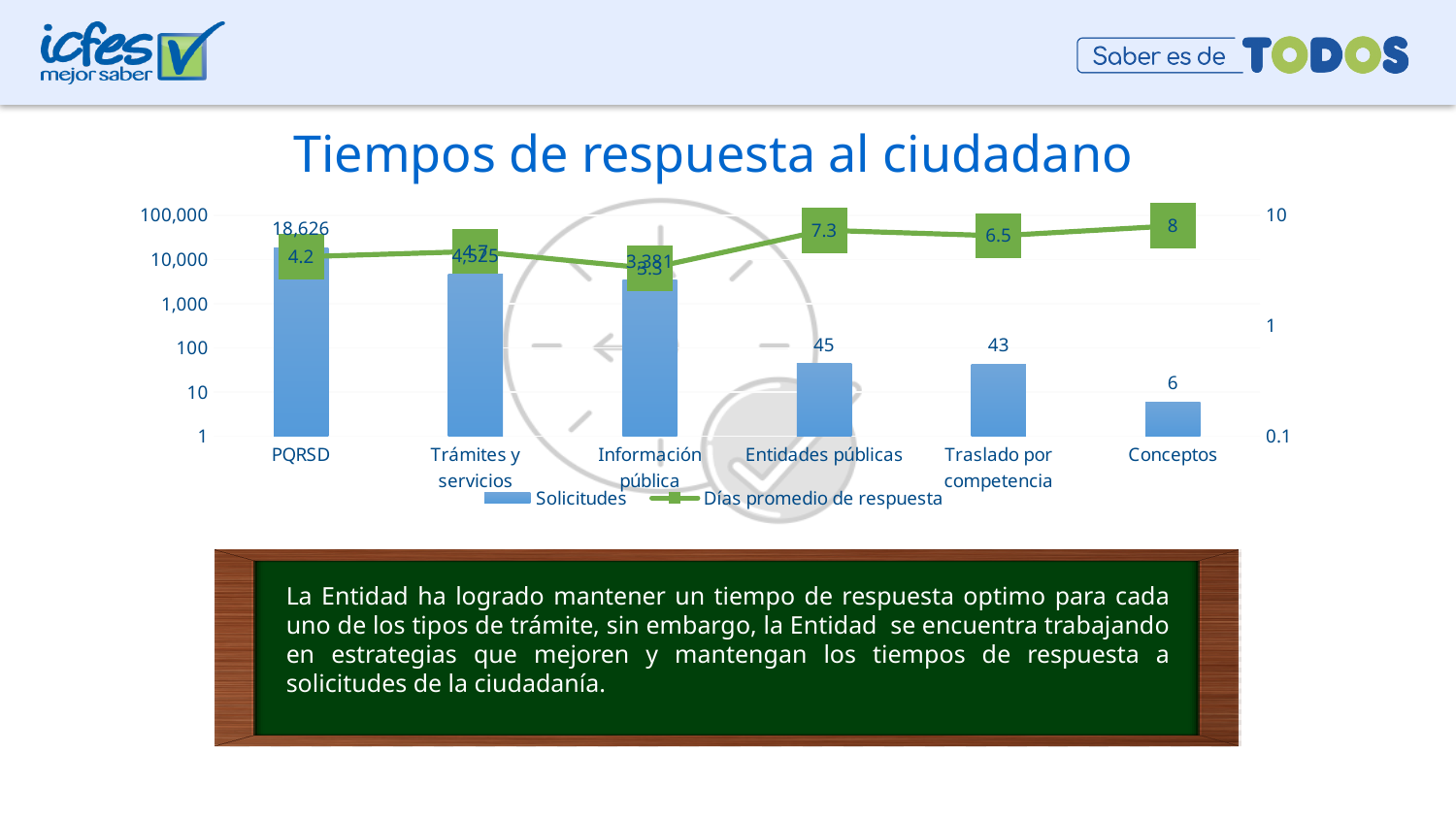
What is the Solicitudes value for PQRSD? 18,626 What is the Días promedio de respuesta value for Entidades públicas? 7.3 How many categories are shown on the x axis? 6 What is the difference in Solicitudes between Entidades públicas and Traslado por competencia? 2 Which category has the highest Solicitudes value? PQRSD What is the Días promedio de respuesta value for Traslado por competencia? 6.5 Which category has the highest Días promedio de respuesta? Conceptos How many series does the legend list? 2 What is the Días promedio de respuesta value for Conceptos? 8 What is the Solicitudes value for Entidades públicas? 45 What is the Solicitudes value for Conceptos? 6 Which category has the lowest Solicitudes value? Conceptos